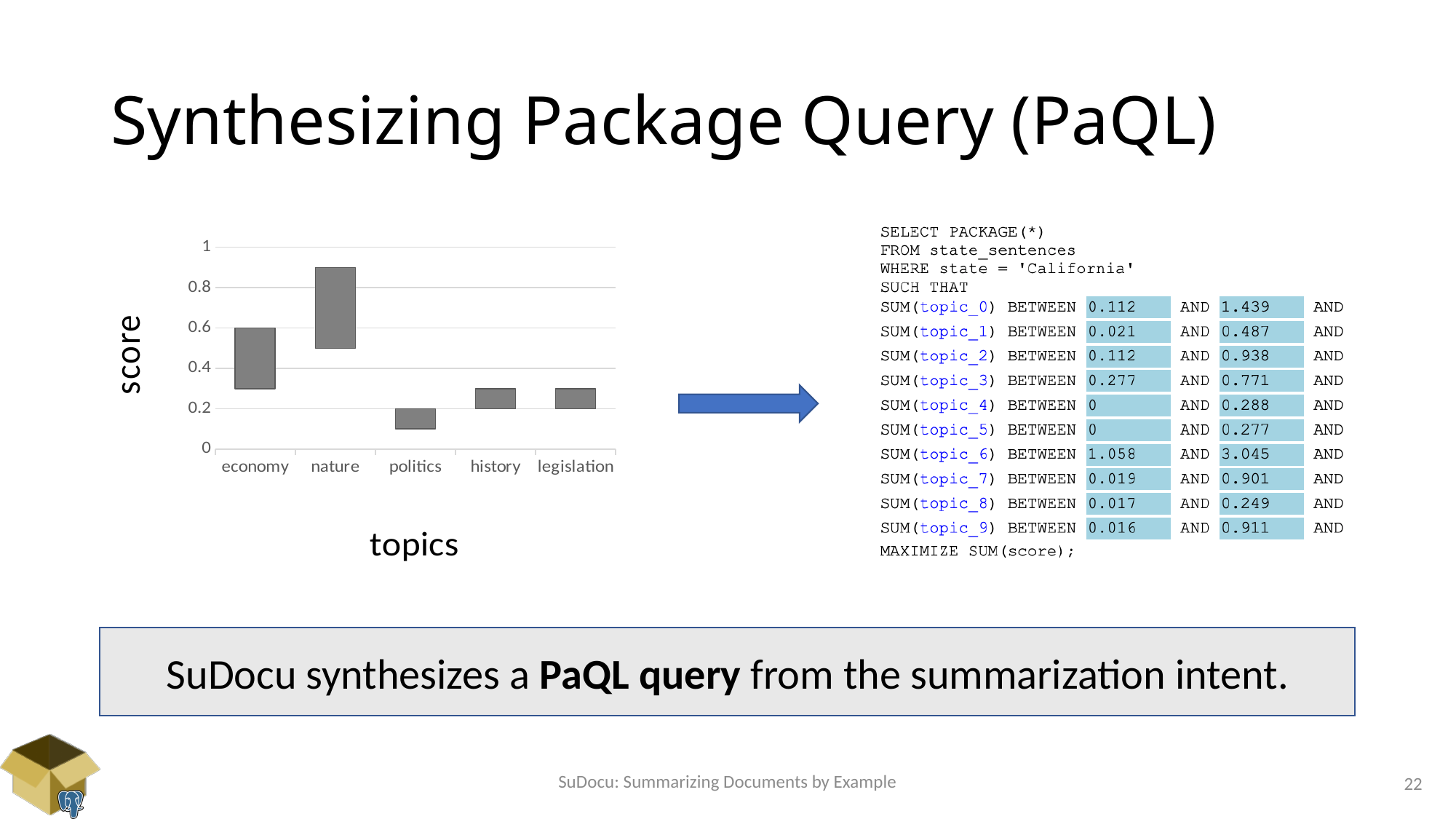
Which topic has the bar that reaches the highest score on the chart? nature Which bar reaches higher on the chart, nature or economy? nature What is the label on the horizontal axis of the chart? topics What kind of chart is shown on the left of the slide? bar chart What is the label on the vertical axis of the chart? score Which bar reaches higher on the chart, economy or politics? economy How many topic categories are shown on the x axis of the chart? 5 Is the top of the bar for economy greater or less than 0.4? greater Which topic has the lowest bar on the chart? politics Does the top of the bar for nature reach greater or less than 0.8? greater Is the top of the bar for history greater or less than 0.6? less